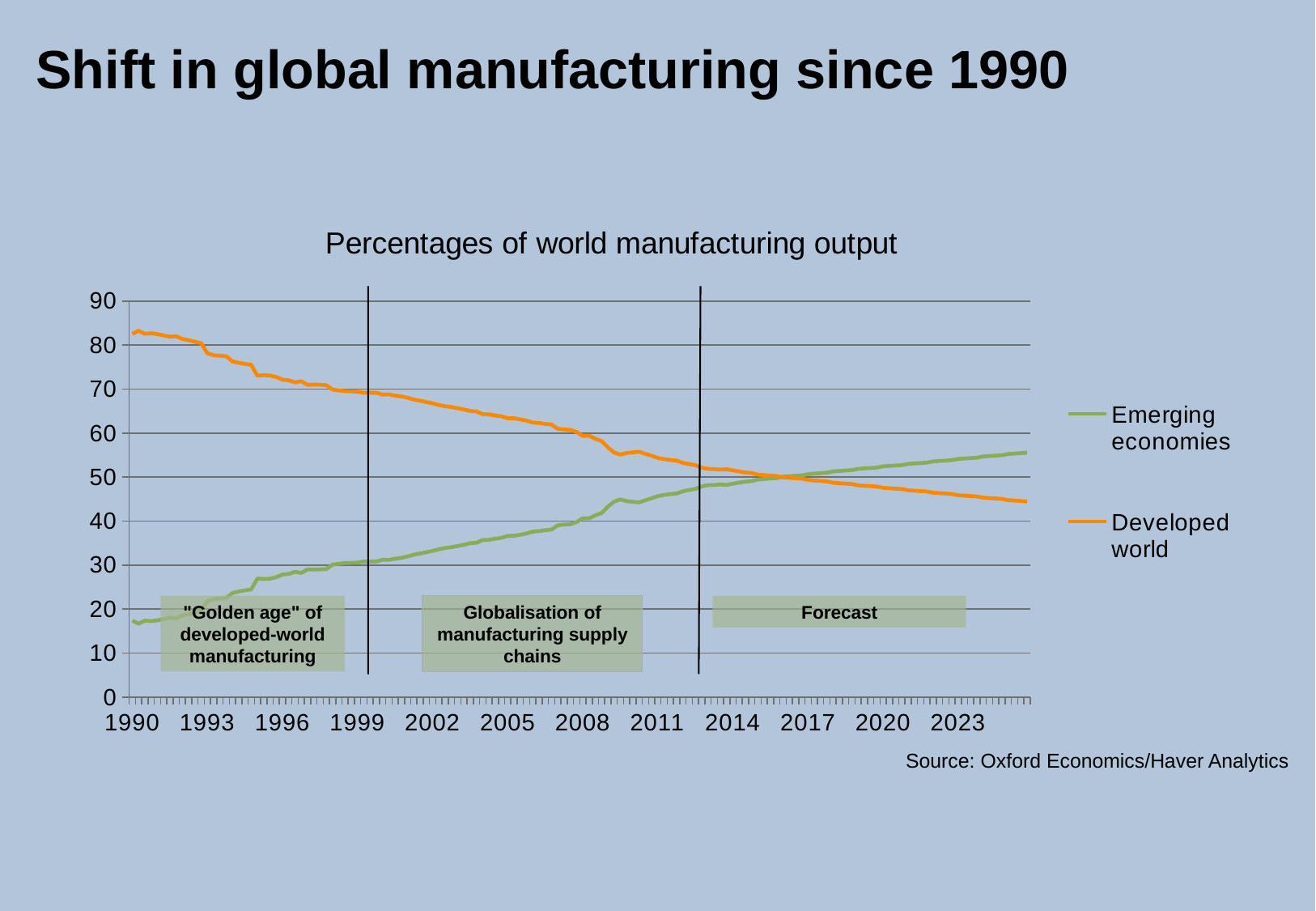
In 1990, which series has the larger value, Emerging economies or Developed world? Developed world Is the value for Emerging economies in 1990 greater or less than 20? less Is the value for Developed world in 2005 greater or less than 60? greater Which series is drawn in orange? Developed world Is the value for Developed world in 1990 greater or less than 80? greater What is the title of the chart? Percentages of world manufacturing output Does the Developed world line rise or fall from 1990 to 2023? fall How many series does the legend list? 2 What kind of chart is shown on the slide? line chart In 2023, which series has the larger value, Emerging economies or Developed world? Emerging economies Does the Emerging economies line rise or fall from 1990 to 2023? rise